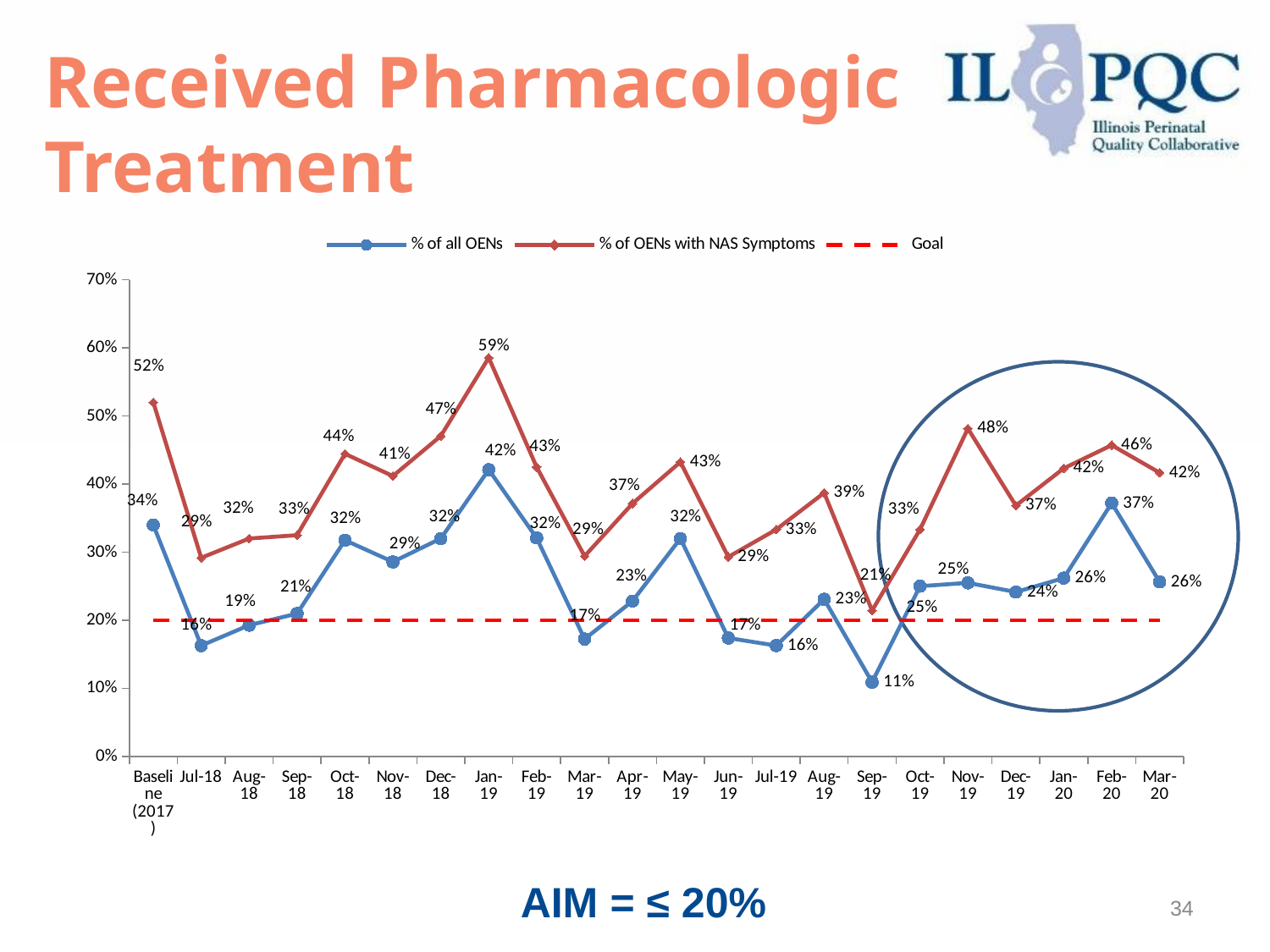
What is the difference between % of OENs with NAS Symptoms and % of all OENs in Mar-20? 16% What type of chart is shown on the slide? Line chart In which month is % of all OENs at its lowest? Sep-19 In which month does % of OENs with NAS Symptoms reach its highest value? Jan-19 How many time points are plotted on the x axis, including Baseline (2017)? 22 Which is larger in Feb-20: % of all OENs or % of OENs with NAS Symptoms? % of OENs with NAS Symptoms What is the value of % of OENs with NAS Symptoms in Nov-19? 48% What is the value of % of all OENs in Sep-19? 11% What is the value of % of OENs with NAS Symptoms in Jan-19? 59% What is the value of % of all OENs at Baseline (2017)? 34% How many series does the legend list? 3 At what value is the Goal line drawn? 20%